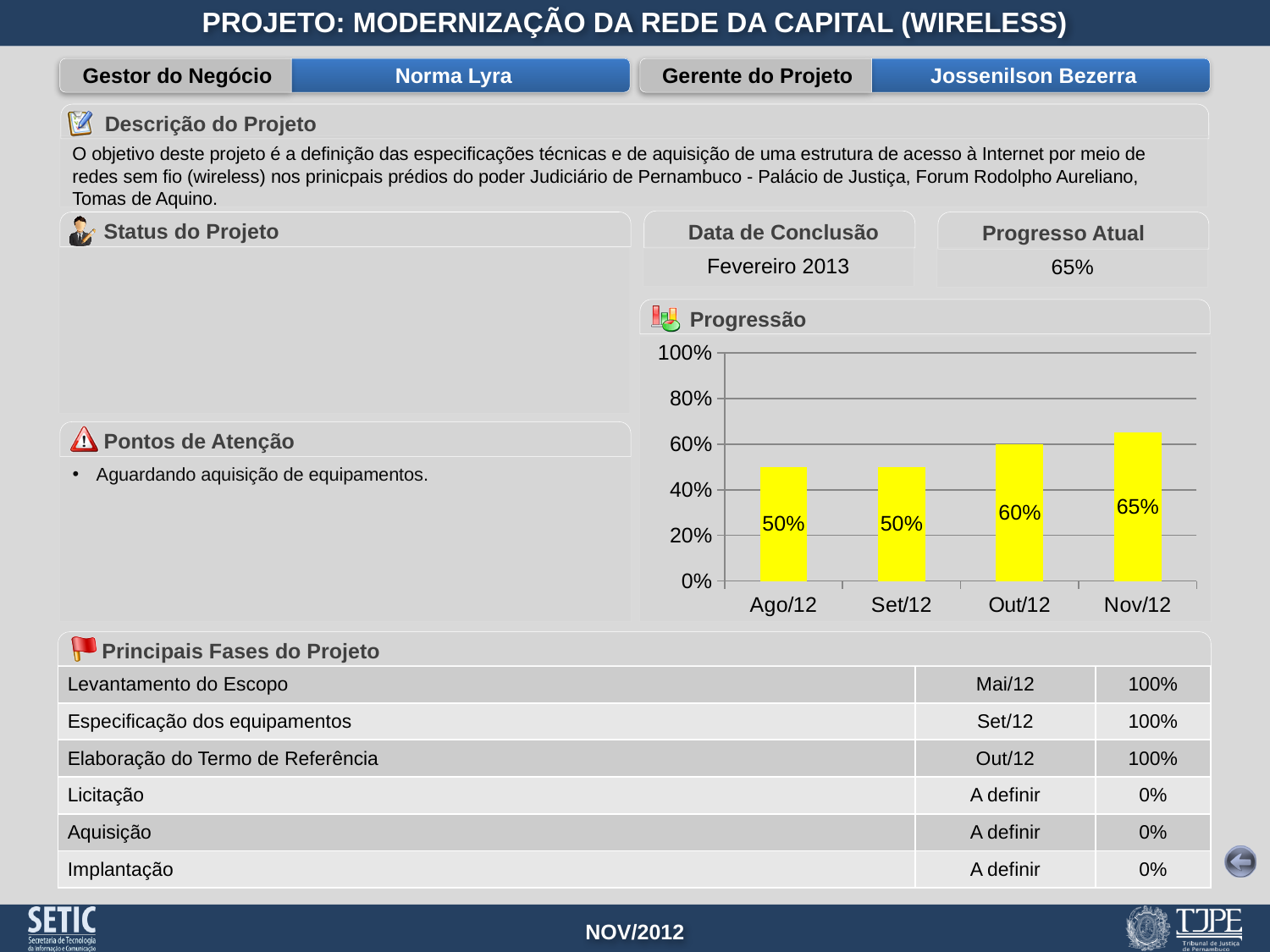
What is the difference between the values for Out/12 and Ago/12 in the Progressão chart? 10% Which month has the highest value in the Progressão chart? Nov/12 Which is larger in the Progressão chart, the value for Out/12 or the value for Set/12? Out/12 What is the value for Ago/12 in the Progressão chart? 50% What kind of chart is the Progressão chart? bar chart Is the value for Nov/12 in the Progressão chart greater or less than 80%? less What is the value for Out/12 in the Progressão chart? 60% How many months are shown on the x axis of the Progressão chart? 4 What colour are the bars in the Progressão chart? yellow What is the value for Nov/12 in the Progressão chart? 65% Do the values in the Progressão chart rise or fall from Ago/12 to Nov/12? rise What is the difference between the values for Nov/12 and Set/12 in the Progressão chart? 15%